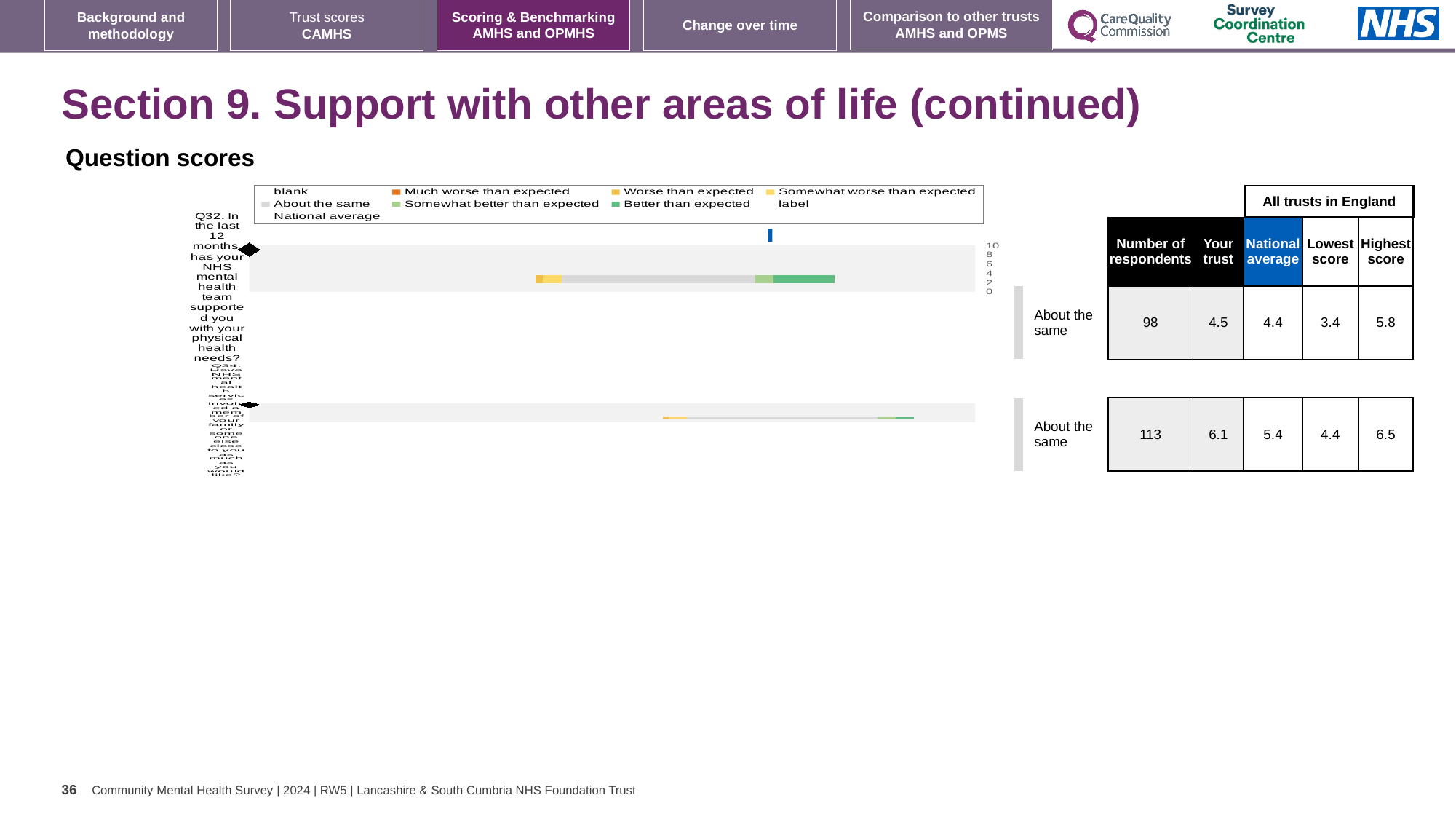
What is the 'Your trust' score for the second question plotted (Q34)? 6.1 For Q32, which is higher: the 'Your trust' score or the national average? Your trust How many survey questions are plotted as bars in the question scores chart? 2 In the question scores chart legend, which entry is shown in orange? Much worse than expected What is the 'Your trust' score for Q32 (support with physical health needs)? 4.5 For Q32, what is the difference between the highest score and the lowest score across all trusts in England? 2.4 What kind of chart is used to show the question scores on this slide? bar chart For the second question plotted (Q34), what is the difference between the highest score and the lowest score across all trusts in England? 2.1 What is the national average score for Q32 (support with physical health needs)? 4.4 What benchmark category is given for Q32 next to the chart? About the same In the question scores chart legend, which entry is shown in dark green? Better than expected How many respondents answered Q32 (support with physical health needs)? 98